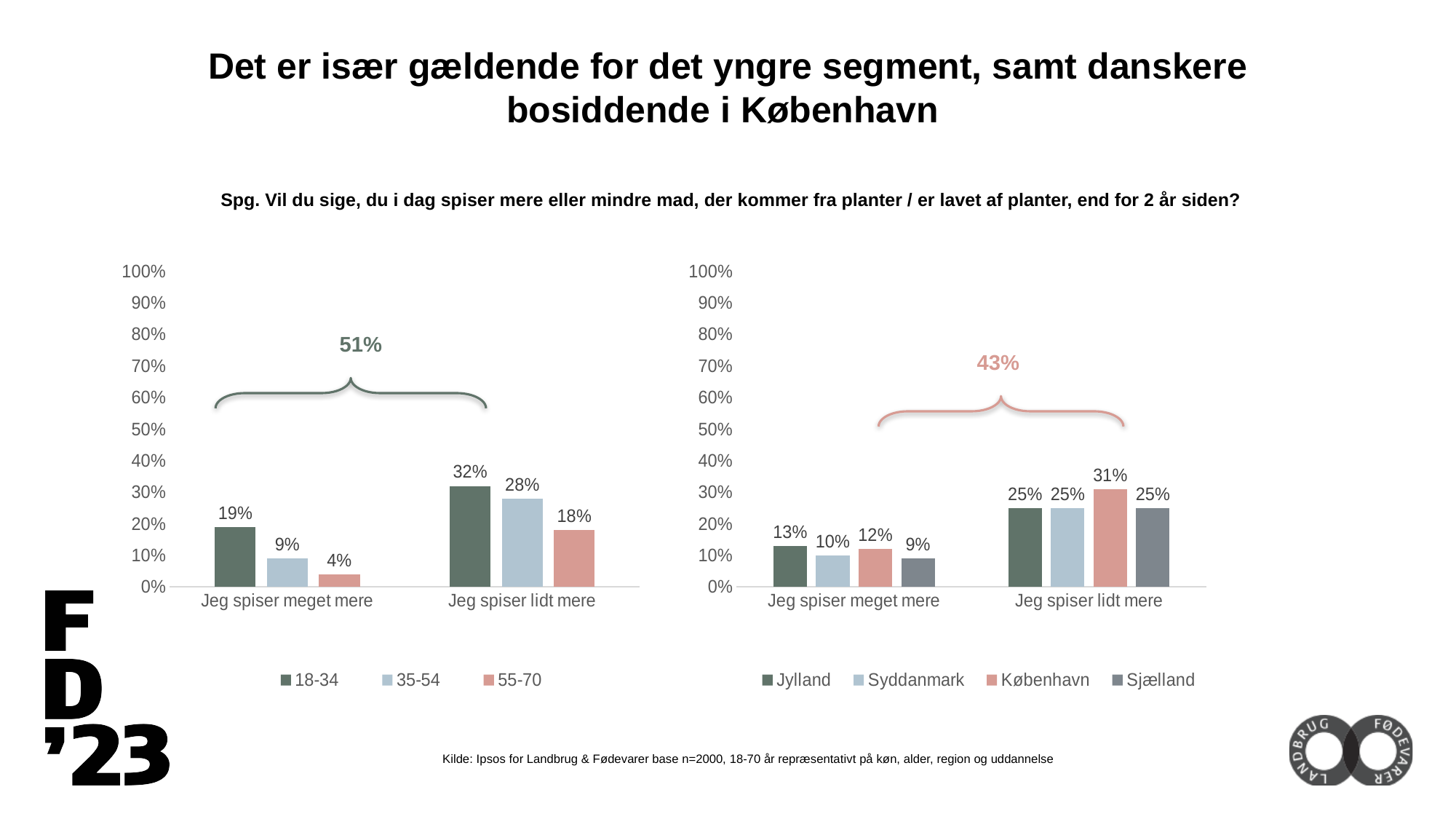
In the left chart, what is the difference between the 18-34 and 35-54 values for 'Jeg spiser lidt mere'? 4% In the right chart, what is the difference between the Jylland and Syddanmark values for 'Jeg spiser meget mere'? 3% In the right chart, what is the value for København for 'Jeg spiser lidt mere'? 31% How many series does the legend of the right chart list? 4 In the left chart, which is larger for 'Jeg spiser meget mere': the 35-54 value or the 55-70 value? 35-54 In the right chart, what percentage is shown above the bracket over 'Jeg spiser lidt mere'? 43% In the left chart, which age group has the lowest value for 'Jeg spiser meget mere'? 55-70 What kind of chart is the left chart? Bar chart In the left chart, what is the value for the 18-34 group for 'Jeg spiser meget mere'? 19% In the right chart, what is the value for Sjælland for 'Jeg spiser meget mere'? 9% In the right chart, which region has the highest value for 'Jeg spiser lidt mere'? København In the left chart, what is the value for the 55-70 group for 'Jeg spiser lidt mere'? 18%